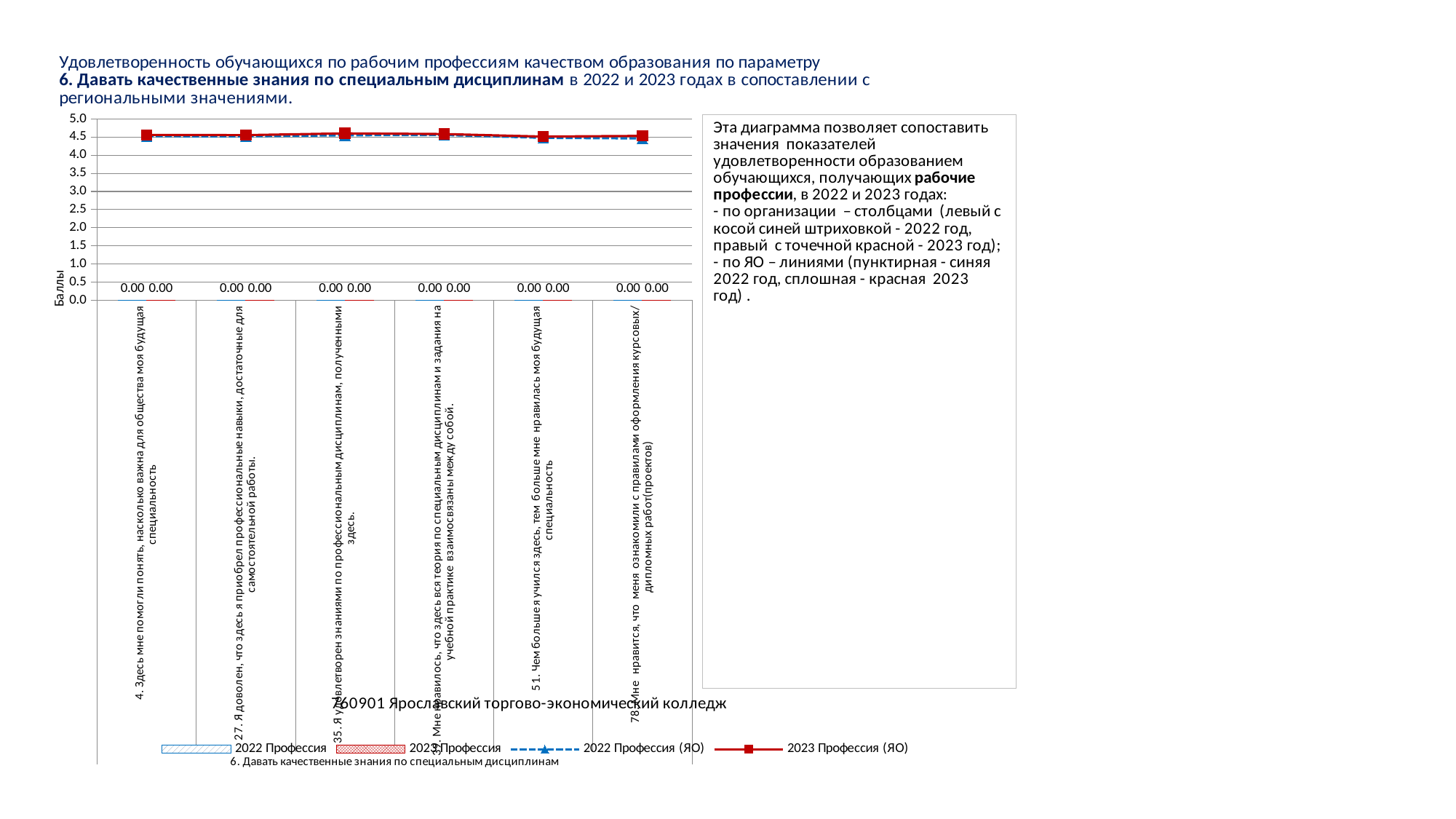
How many categories are plotted along the x axis of the chart? 6 What is the data label shown for the 2022 Профессия bar in the category "4. Здесь мне помогли понять, насколько важна для общества моя будущая специальность"? 0.00 What is the label of the vertical axis of the chart? Баллы Which legend entry is drawn as a solid red line with square markers? 2023 Профессия (ЯО) What is the highest value shown on the vertical axis of the chart? 5.0 What kind of chart is shown on the slide? Combined bar and line chart What is the difference between the 2022 Профессия and 2023 Профессия bar values in the category "27. Я доволен, что здесь я приобрел профессиональные навыки, достаточные для самостоятельной работы"? 0.00 Is the value of the 2023 Профессия (ЯО) line for the category "35. Я удовлетворен знаниями по профессиональным дисциплинам, полученными здесь" greater or less than 3.0? greater Is the value of the 2022 Профессия (ЯО) line for the category "51. Чем больше я учился здесь, тем больше мне нравилась моя будущая специальность" greater or less than 5.0? less Is the value of the 2023 Профессия (ЯО) line for the category "4. Здесь мне помогли понять, насколько важна для общества моя будущая специальность" greater or less than 4.0? greater What is the data label shown for the 2023 Профессия bar in the category "51. Чем больше я учился здесь, тем больше мне нравилась моя будущая специальность"? 0.00 How many series does the chart legend list? 4